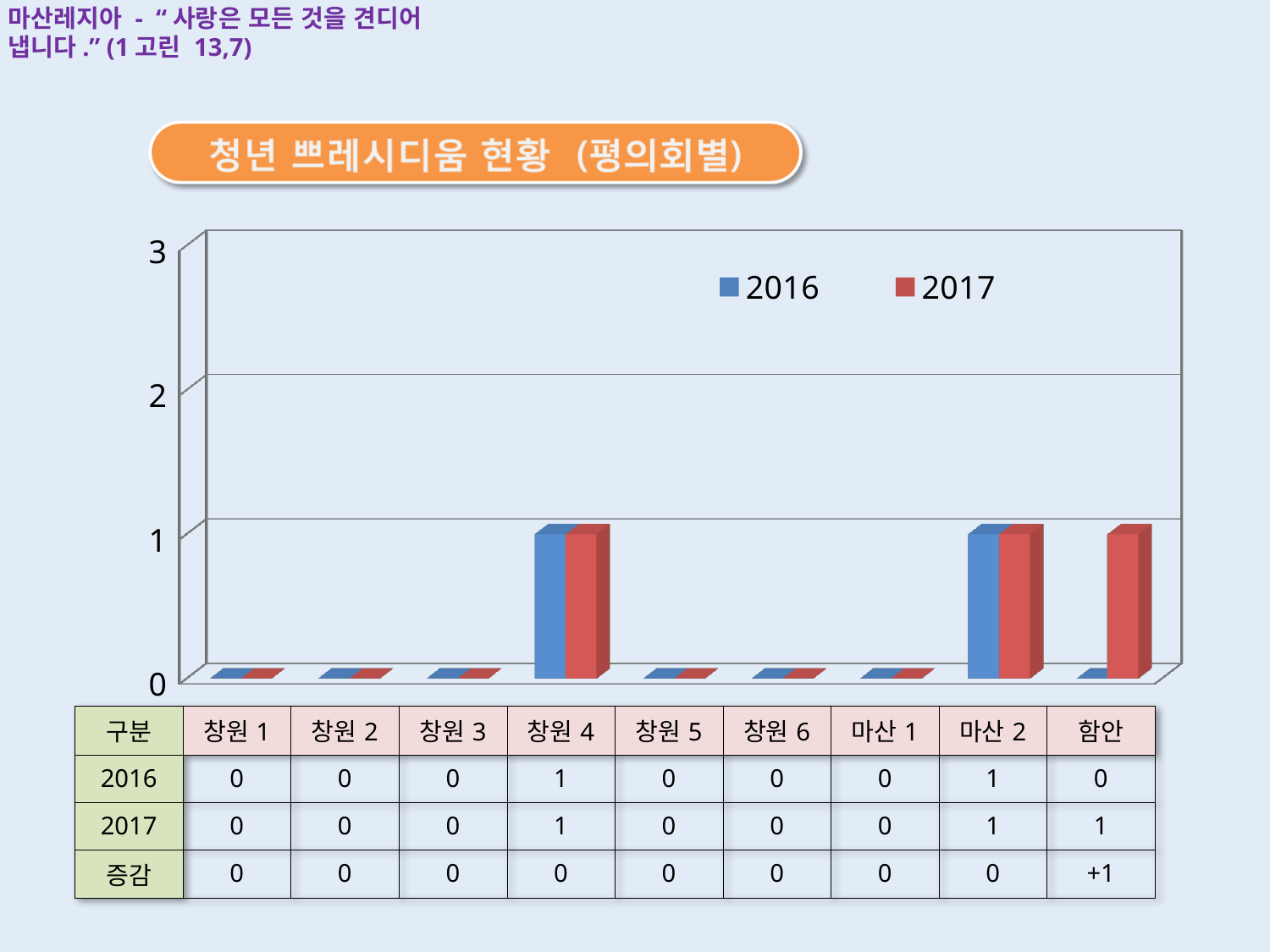
Which is larger for 함안, the 2016 value or the 2017 value? 2017 What is the 2016 value for 함안? 0 Which series is shown in red in the chart legend? 2017 How many series does the chart legend list? 2 What is the difference between the 2017 and 2016 values for 함안? 1 Is the 2017 value for 창원 4 greater or less than 2? less What kind of chart is shown on the slide? bar chart How many categories are shown along the x axis of the chart? 9 What is the 2017 value for 함안? 1 What is the title of the chart? 청년 쁘레시디움 현황 (평의회별) What is the 2016 value for 창원 4? 1 What is the 2017 value for 마산 2? 1